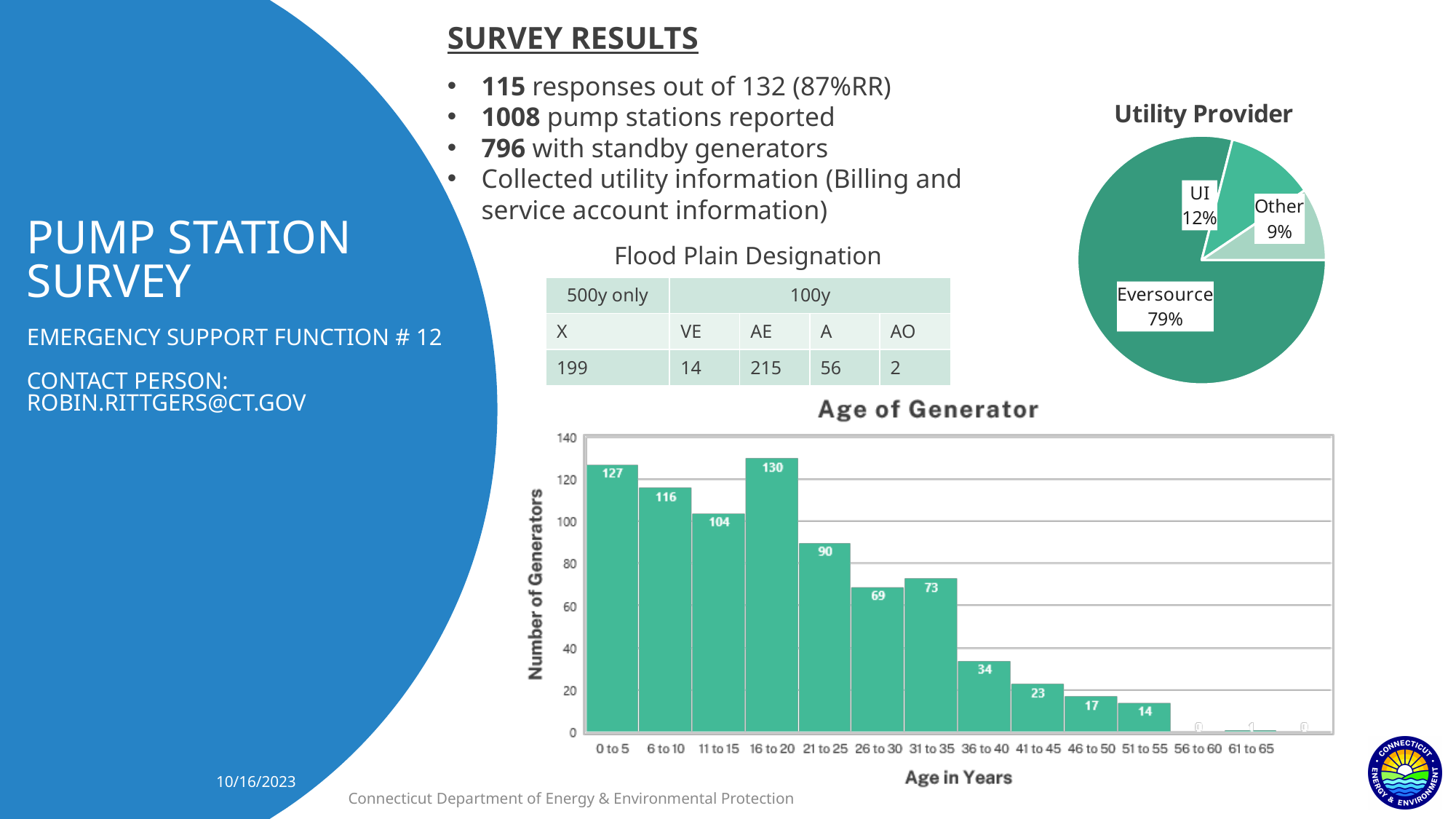
In the Utility Provider pie chart, what share does Eversource have? 79% In the Age of Generator chart, which age category has the highest number of generators? 16 to 20 What kind of chart is the Age of Generator chart? Bar chart In the Age of Generator chart, which has more generators: 26 to 30 or 31 to 35? 31 to 35 How many slices does the Utility Provider pie chart have? 3 In the Age of Generator chart, what is the difference between the 16 to 20 and 21 to 25 categories? 40 In the Age of Generator chart, what is the value for the 36 to 40 years category? 34 In the Age of Generator chart, what is the difference between the 0 to 5 and 6 to 10 categories? 11 In the Age of Generator chart, how many generators are in the 16 to 20 years category? 130 In the Age of Generator chart, what is the value for the 0 to 5 years category? 127 In the Age of Generator chart, do the values generally rise or fall as age in years increases? Fall In the Utility Provider pie chart, which provider has the smallest slice? Other